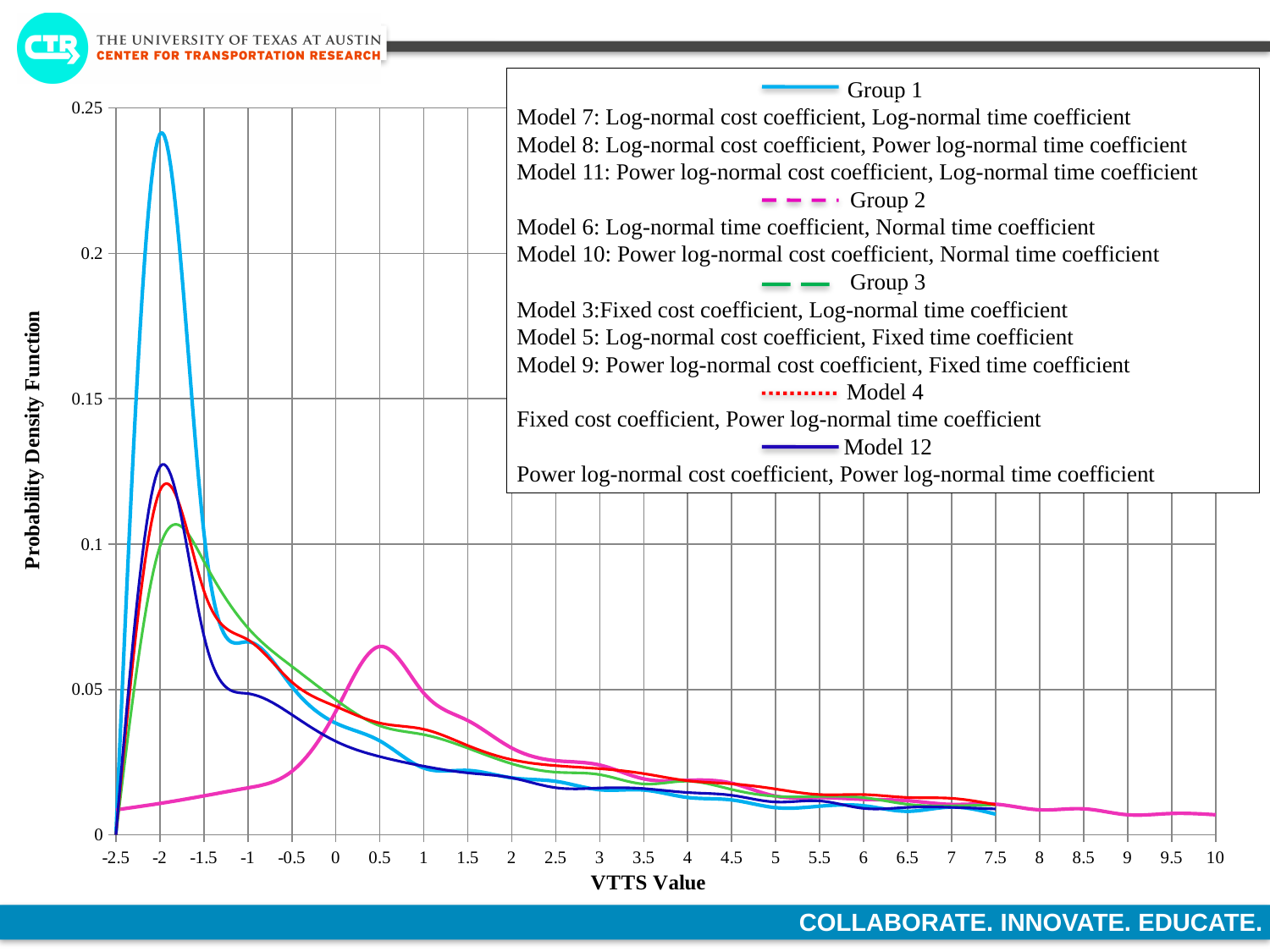
Which curve has a higher peak, Group 1 or Model 12? Group 1 Which series reaches the highest peak value on the chart? Group 1 Which series has its peak at the largest VTTS Value, around 0.5? Group 2 Is the peak value of the Model 12 curve greater or less than 0.1? greater What kind of chart is shown on the slide? line chart What is the title of the x axis? VTTS Value Is the peak value of the Group 1 curve greater or less than 0.2? greater What is the title of the y axis? Probability Density Function How many series does the legend list? 5 Do the values of the Group 1 curve rise or fall as the VTTS Value increases from -2 to 10? fall Is the peak value of the Group 2 curve greater or less than 0.05? greater